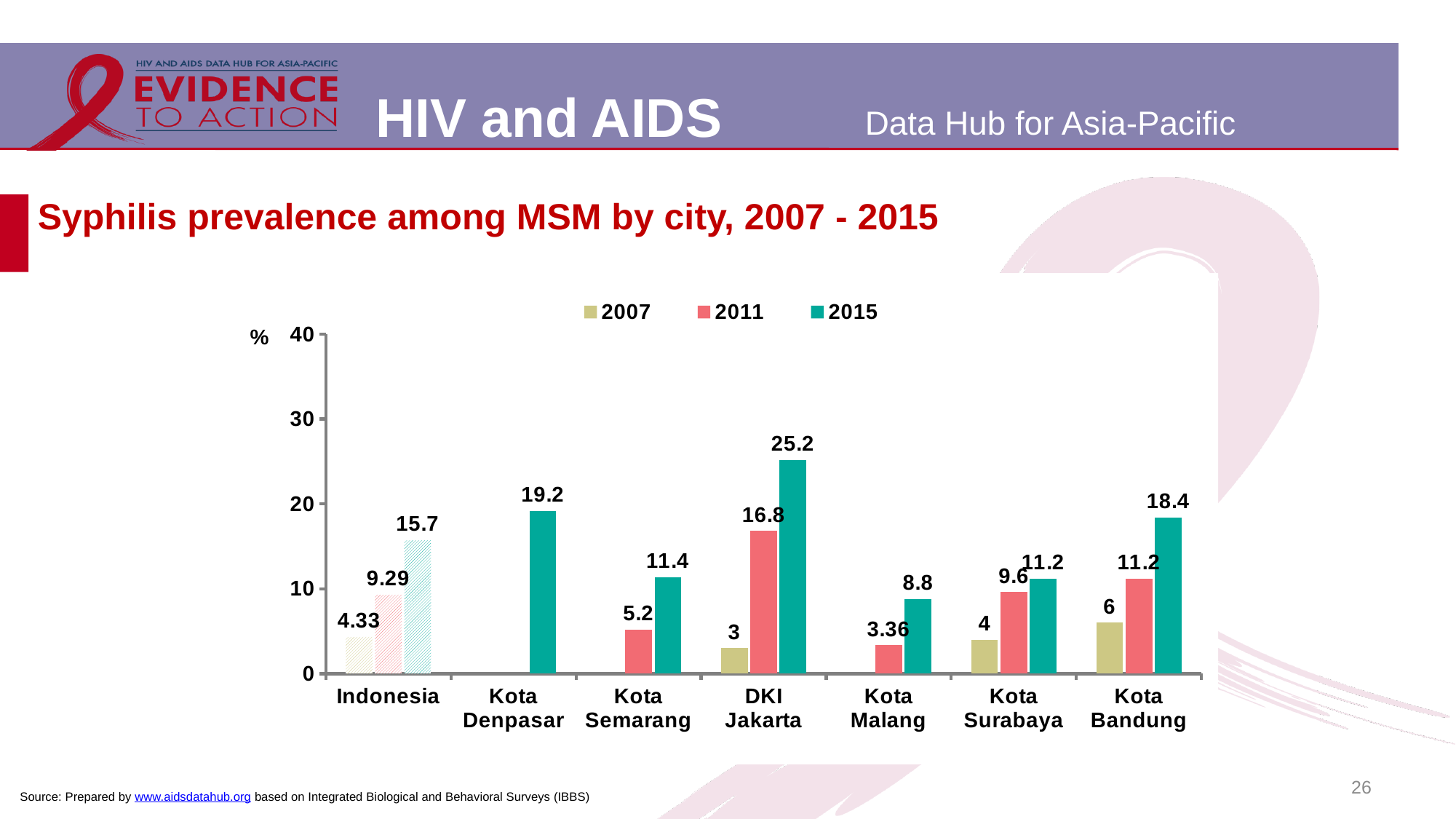
Which category has the lowest 2015 value? Kota Malang Do the values for Indonesia rise or fall from 2007 to 2015? Rise What is the difference between the 2015 and 2011 values for Kota Bandung? 7.2 Which is larger: the 2011 value for DKI Jakarta or the 2011 value for Kota Bandung? DKI Jakarta How many series does the legend list? 3 What is the 2011 value for Kota Malang? 3.36 What is the 2007 value for Indonesia? 4.33 What is the 2015 value for Kota Denpasar? 19.2 What kind of chart is shown on the slide? Bar chart Which city has the highest 2015 value? DKI Jakarta What is the 2015 syphilis prevalence value for DKI Jakarta? 25.2 How many cities or categories are shown on the x axis? 7